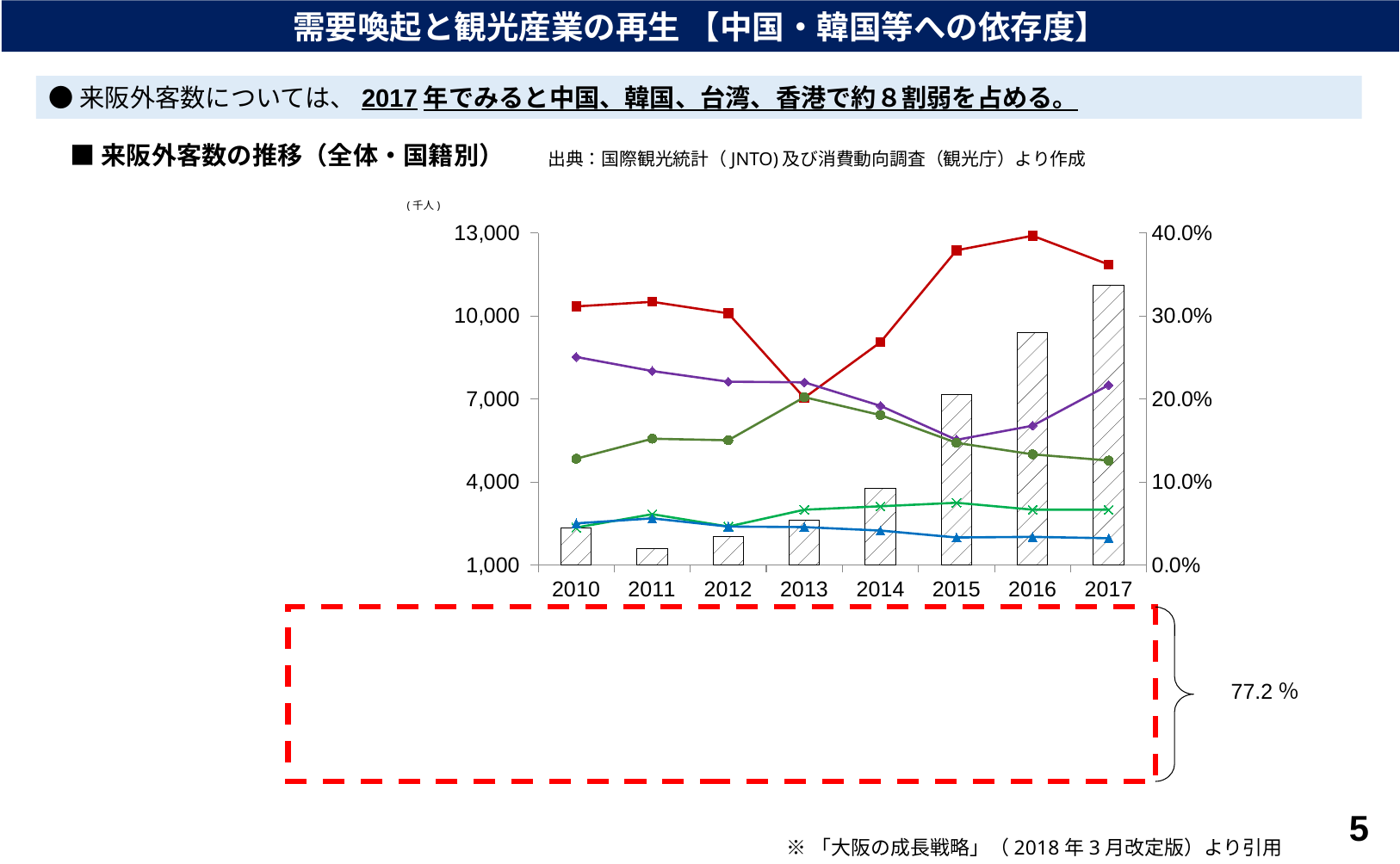
Which year has the tallest bar in the chart? 2017 Is the bar value for 2015 greater or less than 4,000? greater What is the unit shown above the left axis of the chart? 千人 Which year has the larger bar, 2015 or 2016? 2016 What kind of chart is shown on the slide? A combined bar and line chart How many years are shown on the x axis of the chart? 8 In which year does the red line reach its highest point? 2016 Is the bar value for 2017 greater or less than 10,000? greater Do the bars rise or fall from 2013 to 2017? rise In which year does the red line reach its lowest point? 2013 Which year has the shortest bar in the chart? 2011 Is the bar value for 2016 greater or less than 10,000? less